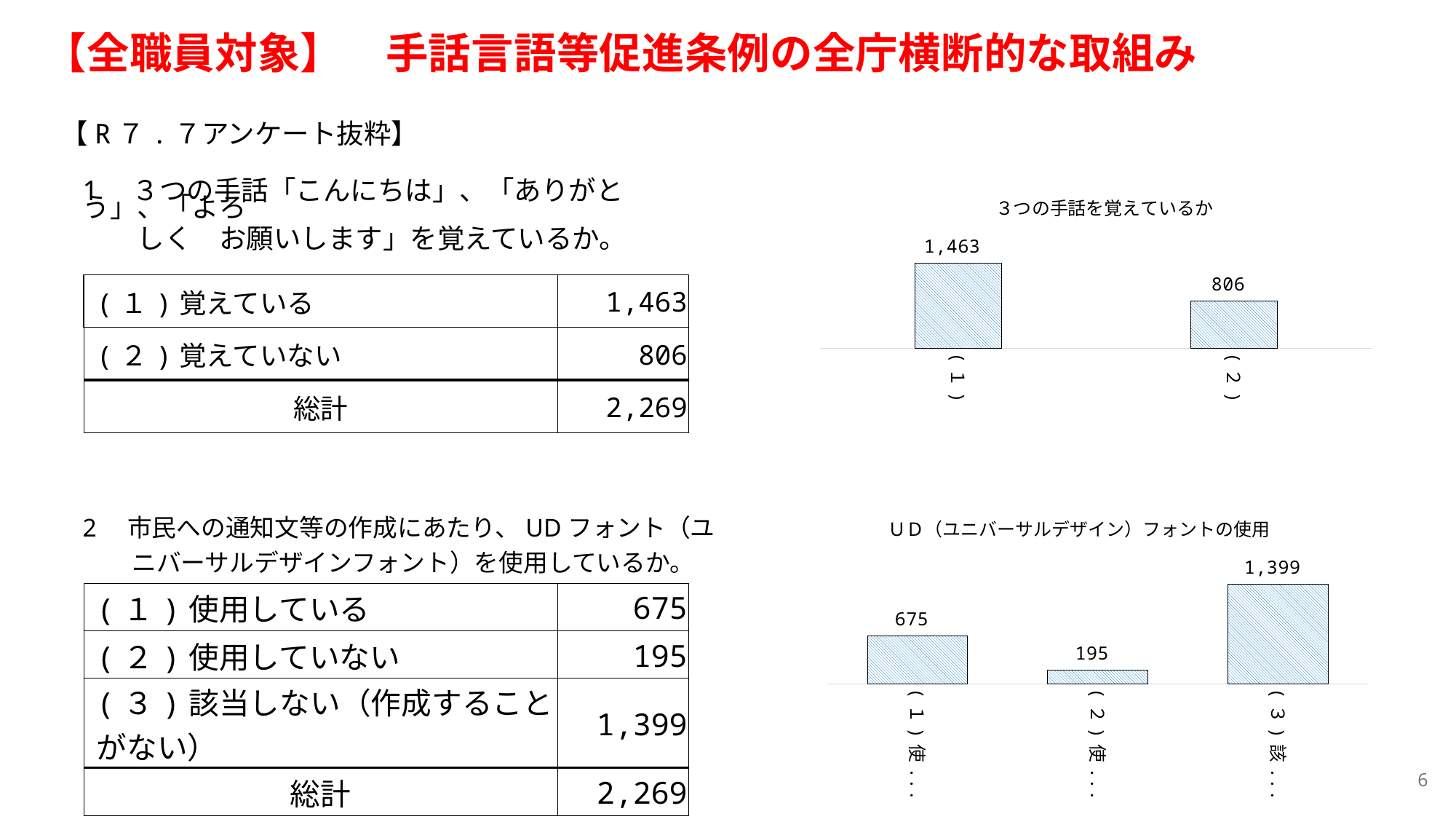
In the top chart titled 「３つの手話を覚えているか」, what is the value for category (1)? 1,463 In the bottom chart titled 「ＵＤ（ユニバーサルデザイン）フォントの使用」, what is the difference between the values for (3) and (1)? 724 In the bottom chart titled 「ＵＤ（ユニバーサルデザイン）フォントの使用」, which category has the lowest value? (2) In the bottom chart titled 「ＵＤ（ユニバーサルデザイン）フォントの使用」, how many bars are plotted? 3 In the bottom chart titled 「ＵＤ（ユニバーサルデザイン）フォントの使用」, what is the value for category (1)? 675 In the top chart titled 「３つの手話を覚えているか」, how many bars are plotted? 2 In the top chart titled 「３つの手話を覚えているか」, which category has the higher value? (1) In the top chart titled 「３つの手話を覚えているか」, what is the difference between the values for (1) and (2)? 657 In the bottom chart titled 「ＵＤ（ユニバーサルデザイン）フォントの使用」, what is the value for category (3)? 1,399 In the bottom chart titled 「ＵＤ（ユニバーサルデザイン）フォントの使用」, which category has the highest value? (3) What type of chart is the top chart titled 「３つの手話を覚えているか」? Bar chart In the top chart titled 「３つの手話を覚えているか」, what is the value for category (2)? 806